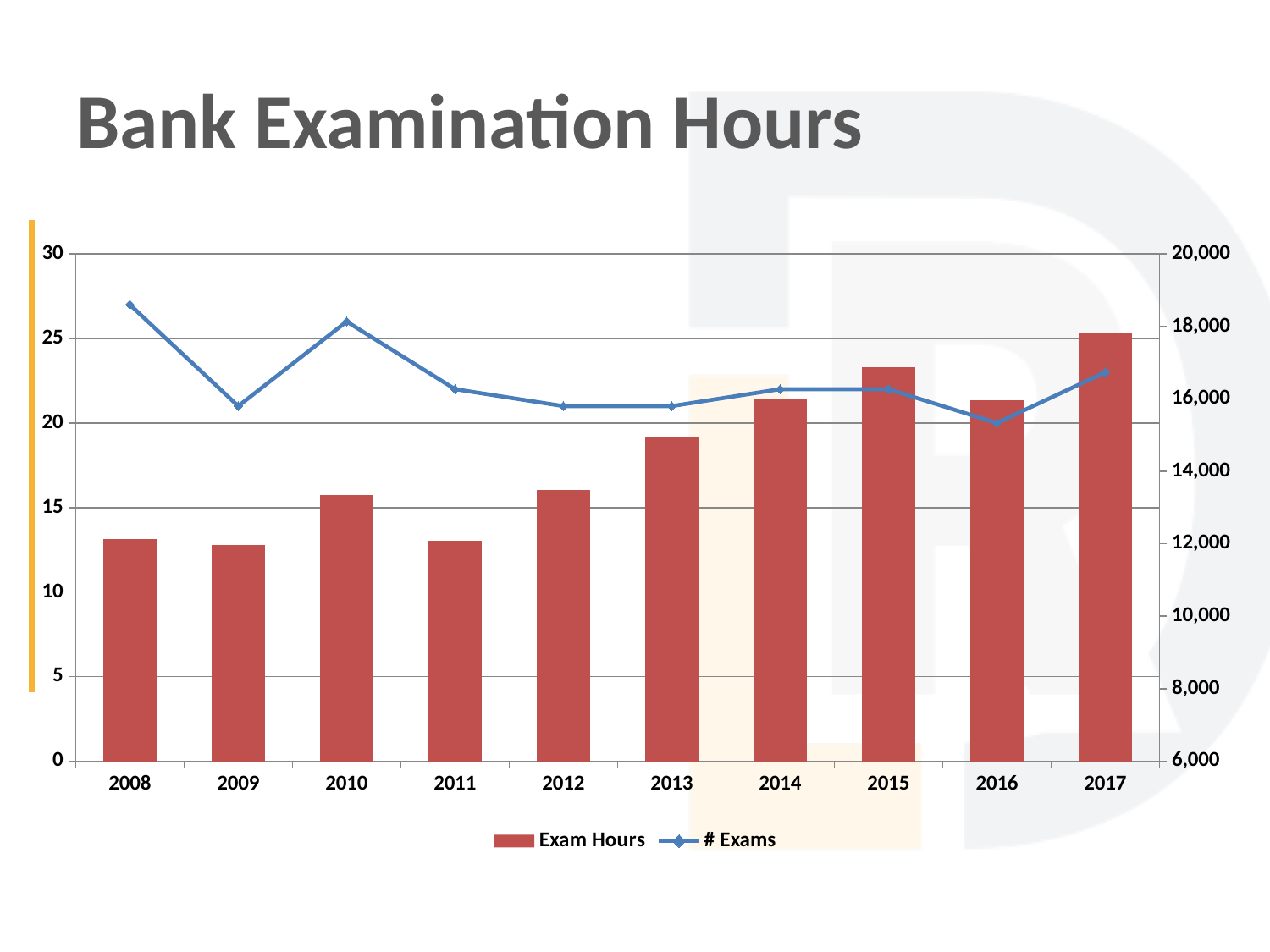
Which year has the highest Exam Hours bar? 2017 Which year has the larger # Exams value, 2008 or 2009? 2008 Do the Exam Hours bars generally rise or fall from 2008 to 2017? Rise How many series does the legend list? 2 Is the Exam Hours value for 2017 greater or less than 20? greater Which year has the highest value for # Exams? 2008 Which year has the larger Exam Hours bar, 2014 or 2015? 2015 How many years are shown on the x axis? 10 Which year has the lowest value for # Exams? 2016 What kind of chart is shown on the slide? A combined bar and line chart